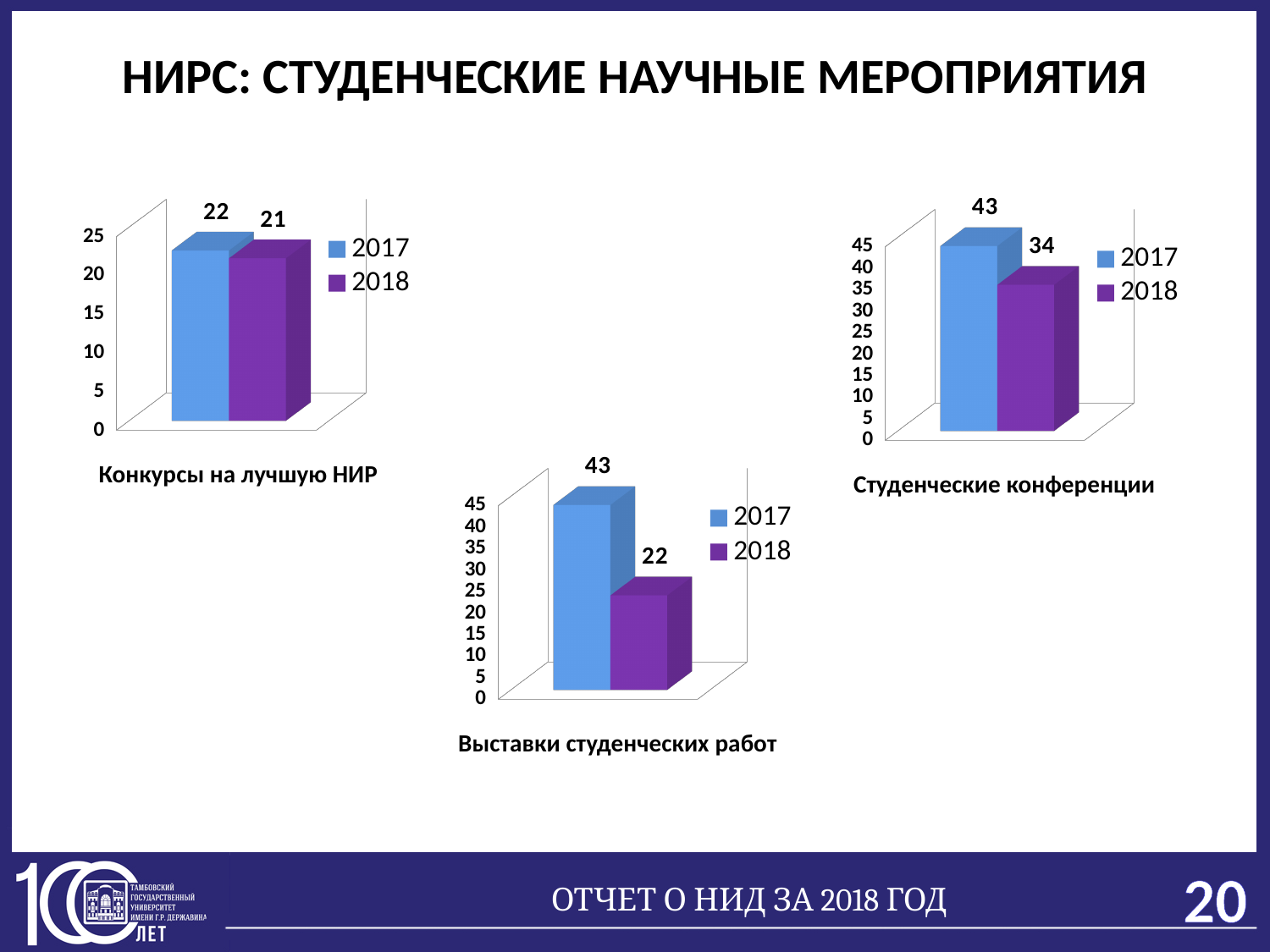
In the 'Выставки студенческих работ' chart, what is the value for 2017? 43 In the 'Конкурсы на лучшую НИР' chart, what is the value for 2017? 22 In the 'Выставки студенческих работ' chart, which year has the lowest value? 2018 In the 'Студенческие конференции' chart, is the value for 2018 greater or less than 30? greater In the 'Студенческие конференции' chart, what is the value for 2018? 34 In the 'Конкурсы на лучшую НИР' chart, what colour is the bar for 2018? purple What kind of chart is the 'Студенческие конференции' chart? bar chart In the 'Конкурсы на лучшую НИР' chart, which year has the higher value, 2017 or 2018? 2017 In the 'Выставки студенческих работ' chart, what is the difference between the 2017 and 2018 values? 21 In the 'Конкурсы на лучшую НИР' chart, what is the value for 2018? 21 How many series does the legend of the 'Выставки студенческих работ' chart list? 2 In the 'Студенческие конференции' chart, what is the difference between the 2017 and 2018 values? 9